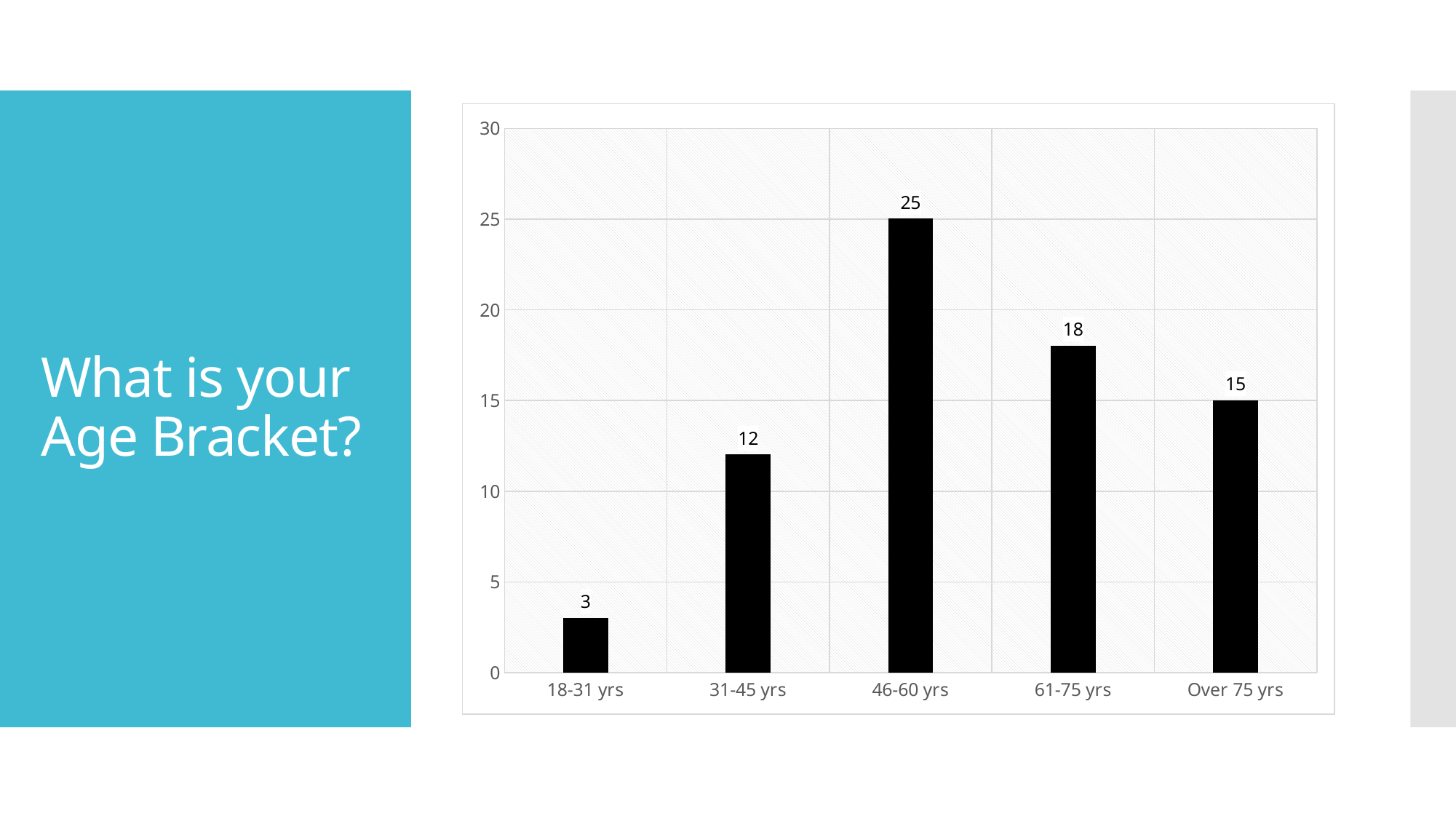
What kind of chart is shown on the slide? bar chart What is the difference between the values for 46-60 yrs and 61-75 yrs? 7 What is the value for the Over 75 yrs age bracket? 15 Is the value for 31-45 yrs greater or less than 10? greater Which is larger, the value for 61-75 yrs or the value for Over 75 yrs? 61-75 yrs What is the title of the slide containing the chart? What is your Age Bracket? Which age bracket has the lowest value? 18-31 yrs What is the value for the 46-60 yrs age bracket? 25 What is the value for the 18-31 yrs age bracket? 3 Which age bracket has the highest value? 46-60 yrs What is the difference between the values for 31-45 yrs and 18-31 yrs? 9 How many age brackets are shown on the chart? 5